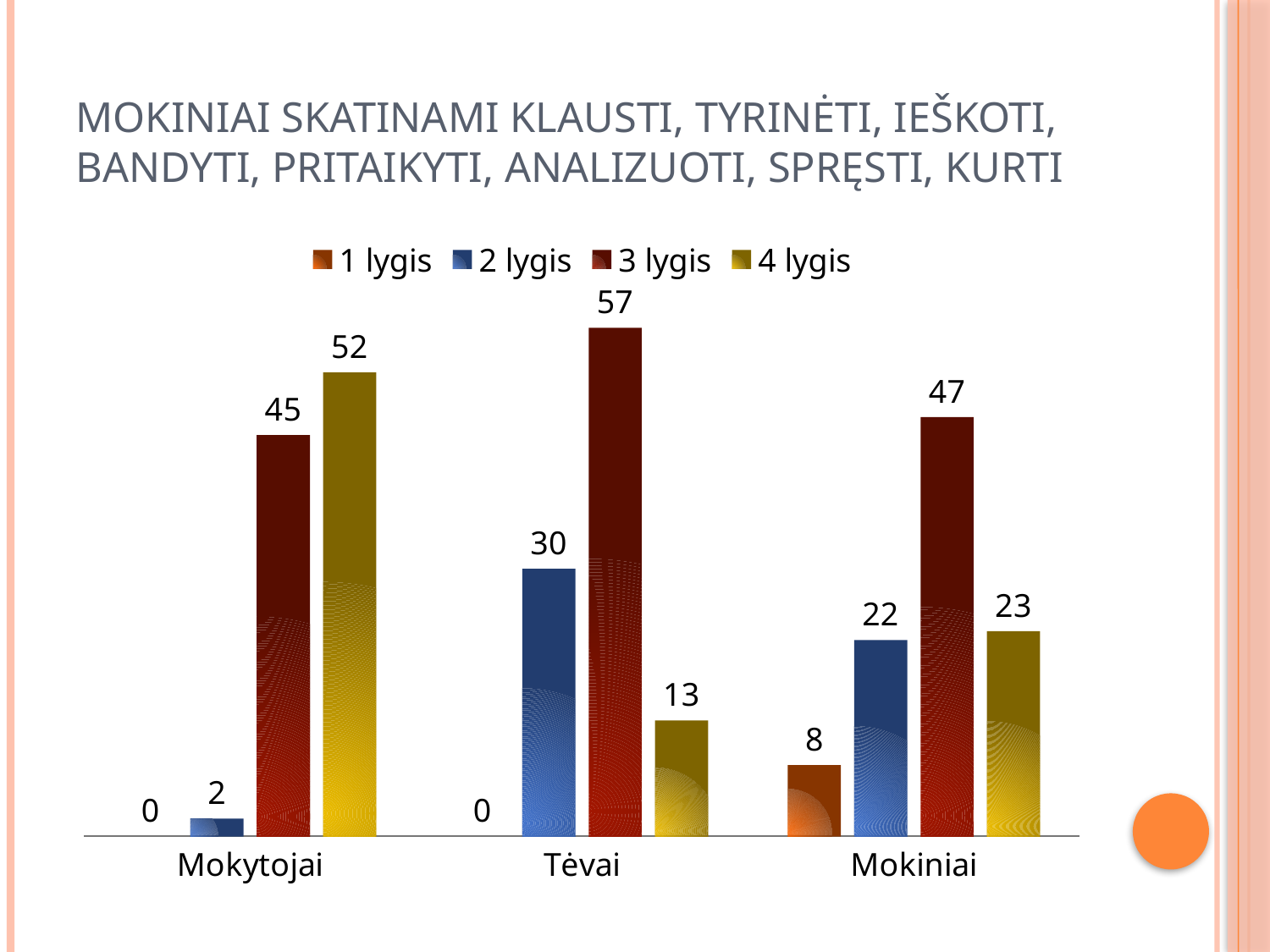
How many series does the legend list? 4 What is the value for 1 lygis in the Mokiniai category? 8 What is the value for 2 lygis in the Tėvai category? 30 What is the value for 1 lygis in the Mokytojai category? 0 What is the value for 4 lygis in the Mokytojai category? 52 What is the difference between the 3 lygis and 4 lygis values in the Mokiniai category? 24 How many categories are shown on the x axis? 3 Which category has the highest value for 3 lygis? Tėvai What is the value for 3 lygis in the Tėvai category? 57 Which is larger in the Mokytojai category: 3 lygis or 4 lygis? 4 lygis What kind of chart is shown on the slide? Bar chart Which category has the lowest value for 4 lygis? Tėvai